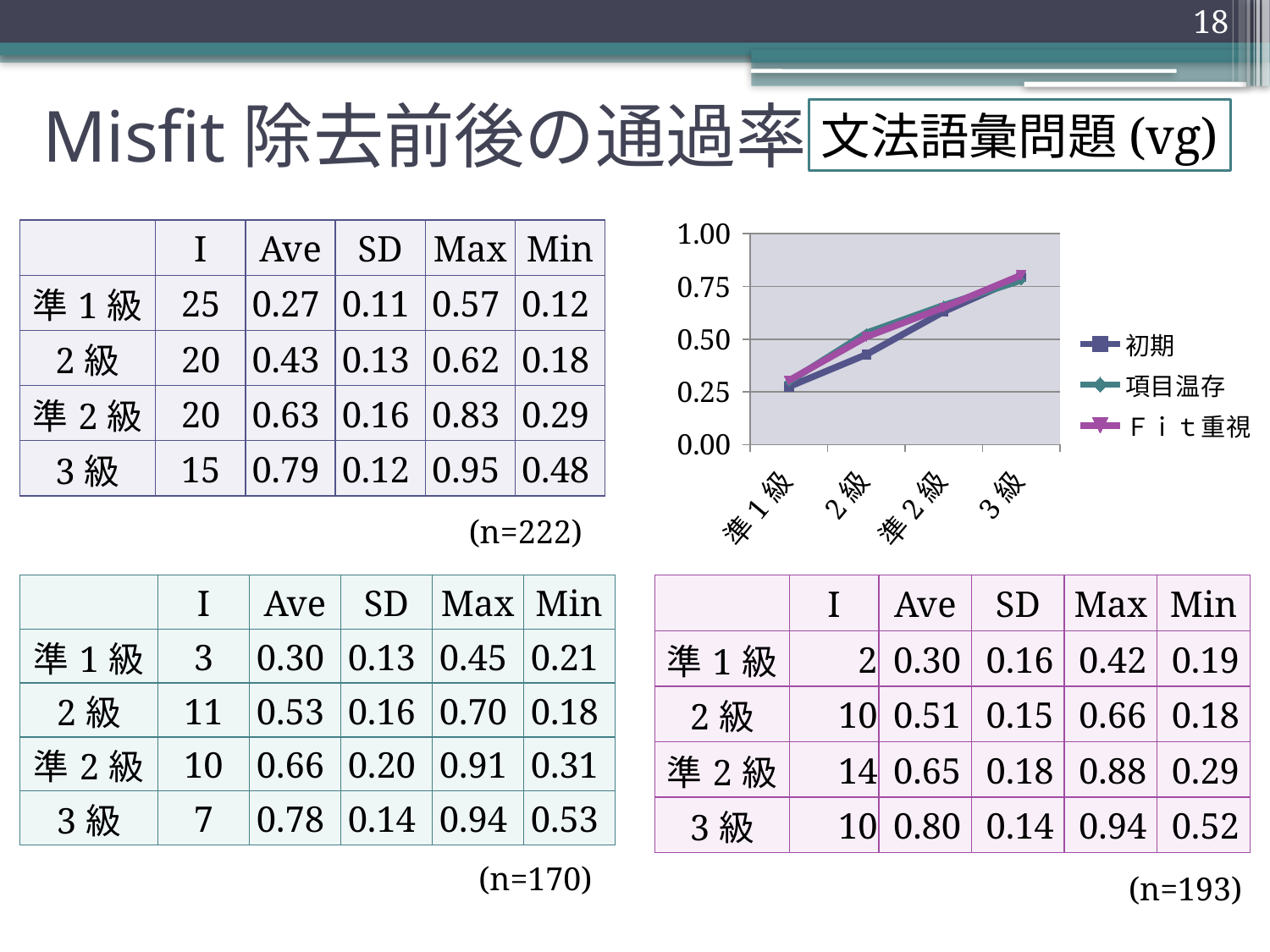
What are the three legend entries of the chart? 初期, 項目温存, Fit重視 For which category is the 初期 series highest in the chart? 3級 How many categories are shown on the x axis of the chart? 4 How many series does the chart's legend list? 3 What kind of chart is shown on the slide? line chart At 2級, which series has the lower value in the chart, 初期 or 項目温存? 初期 Is the value for Fit重視 at 準2級 greater or less than 0.75? less Is the value for 初期 at 準1級 greater or less than 0.50? less For which category is the 初期 series lowest in the chart? 準1級 Is the value for 初期 at 2級 greater or less than 0.50? less Do the values in the chart rise or fall from 準1級 to 3級? rise